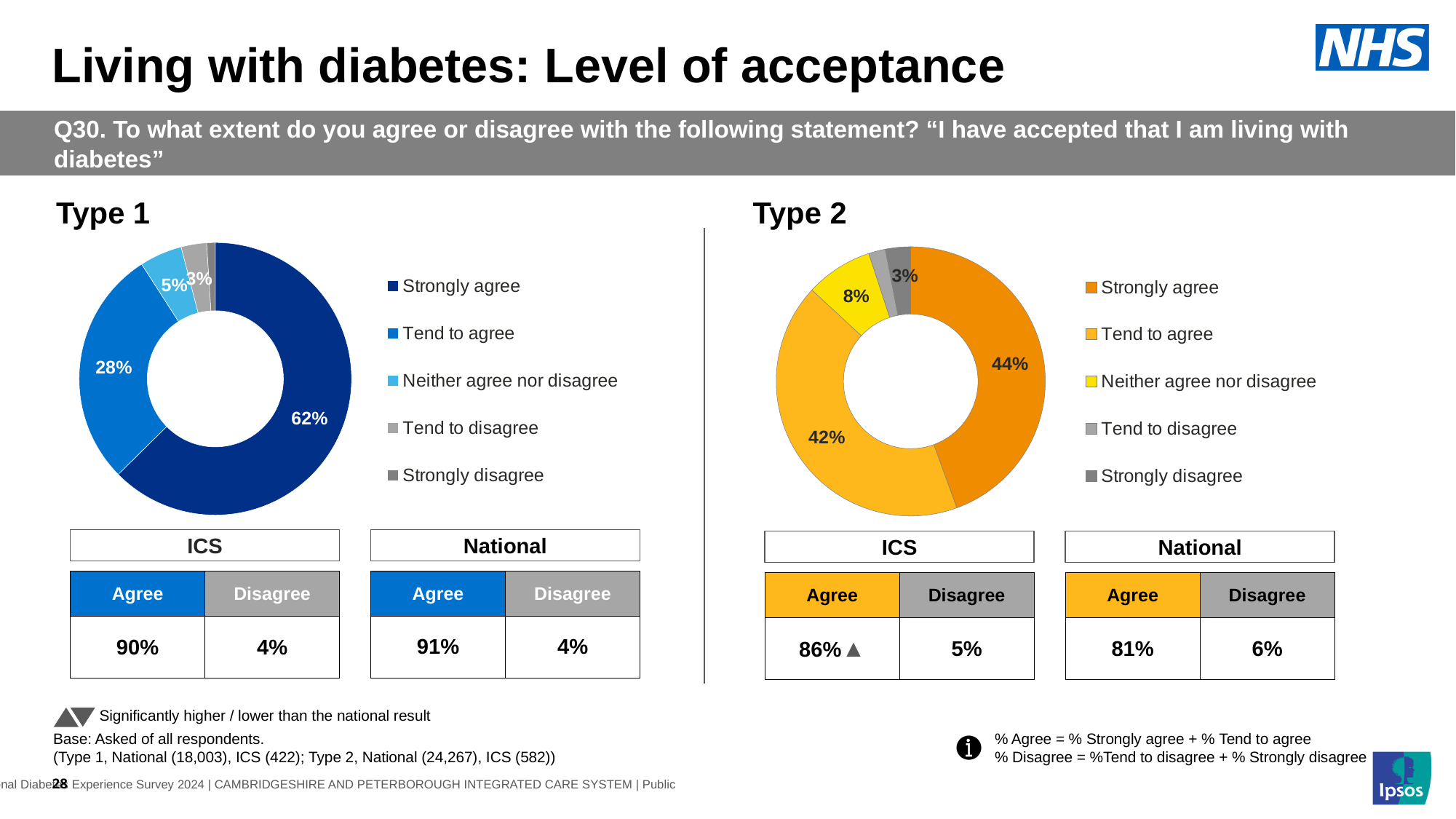
In the Type 1 chart, what percentage of respondents tend to agree? 28% In the Type 2 chart, which response category has the largest share? Strongly agree What kind of chart is used to show the Type 2 results? Donut (pie) chart In the Type 1 chart, what percentage of respondents neither agree nor disagree? 5% What colour represents Strongly agree in the Type 2 chart? Orange In the Type 1 chart, what percentage of respondents strongly agree? 62% In the Type 2 chart, which is larger: Tend to agree or Neither agree nor disagree? Tend to agree How many response categories does the legend of the Type 1 chart list? 5 In the Type 1 chart, which response category has the largest share? Strongly agree In the Type 1 chart, what is the difference in percentage points between Strongly agree and Tend to agree? 34 percentage points In the Type 2 chart, what percentage of respondents strongly agree? 44% In the Type 2 chart, what percentage of respondents neither agree nor disagree? 8%